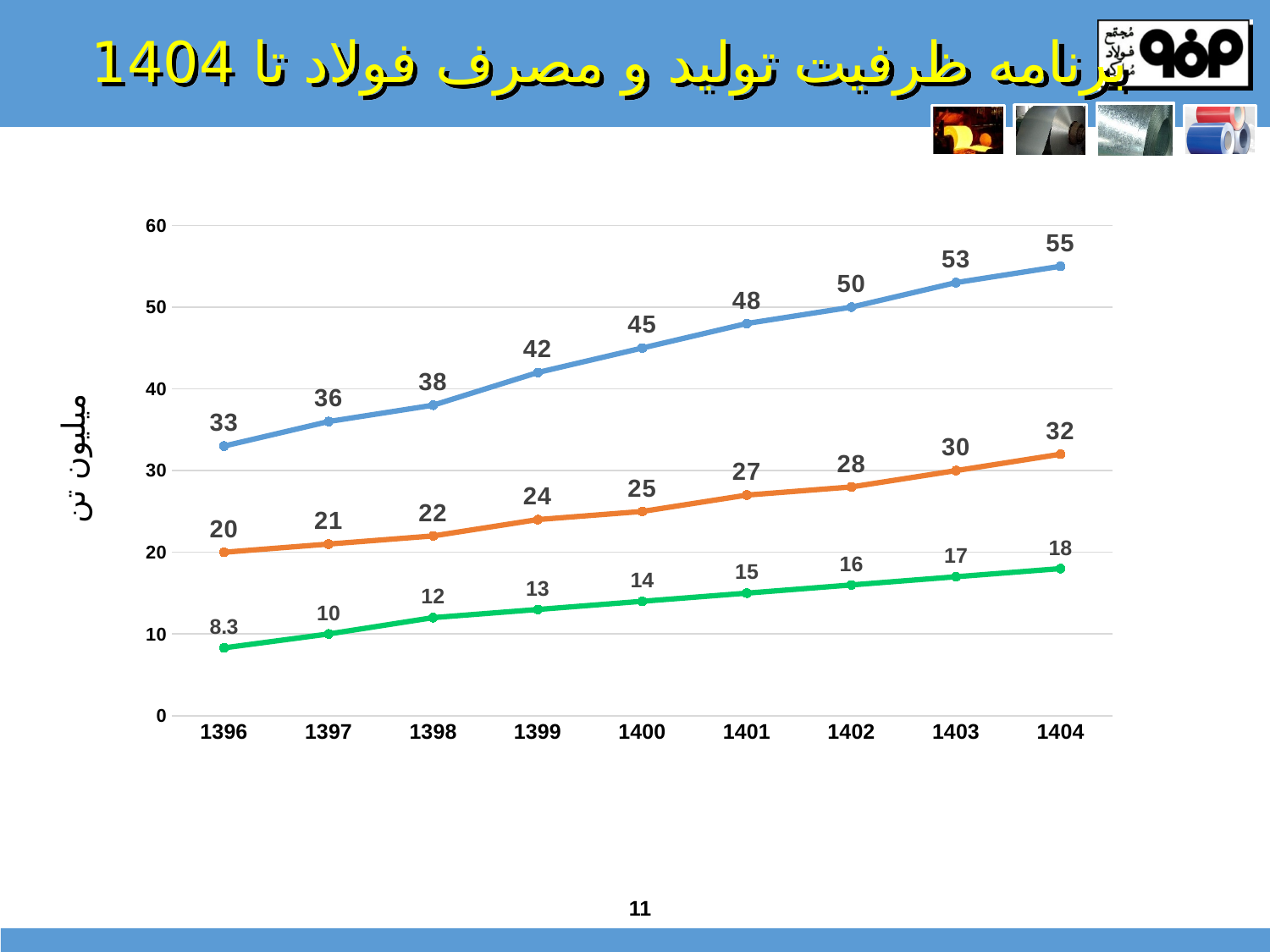
What is the value of the blue line in 1404? 55 In which year is the green line at its lowest value? 1396 Do the values of the orange line rise or fall from 1396 to 1404? rise By how much does the green line increase from 1396 to 1404? 9.7 In which year does the blue line reach its highest value? 1404 Which is larger in 1402, the orange line value or the green line value? the orange line (28) How many years are shown on the x axis? 9 What is the difference between the blue line and the orange line in 1400? 20 What kind of chart is shown on the slide? line chart What is the label on the vertical axis of the chart? میلیون تن What is the value of the orange line in 1399? 24 What is the value of the green line in 1396? 8.3